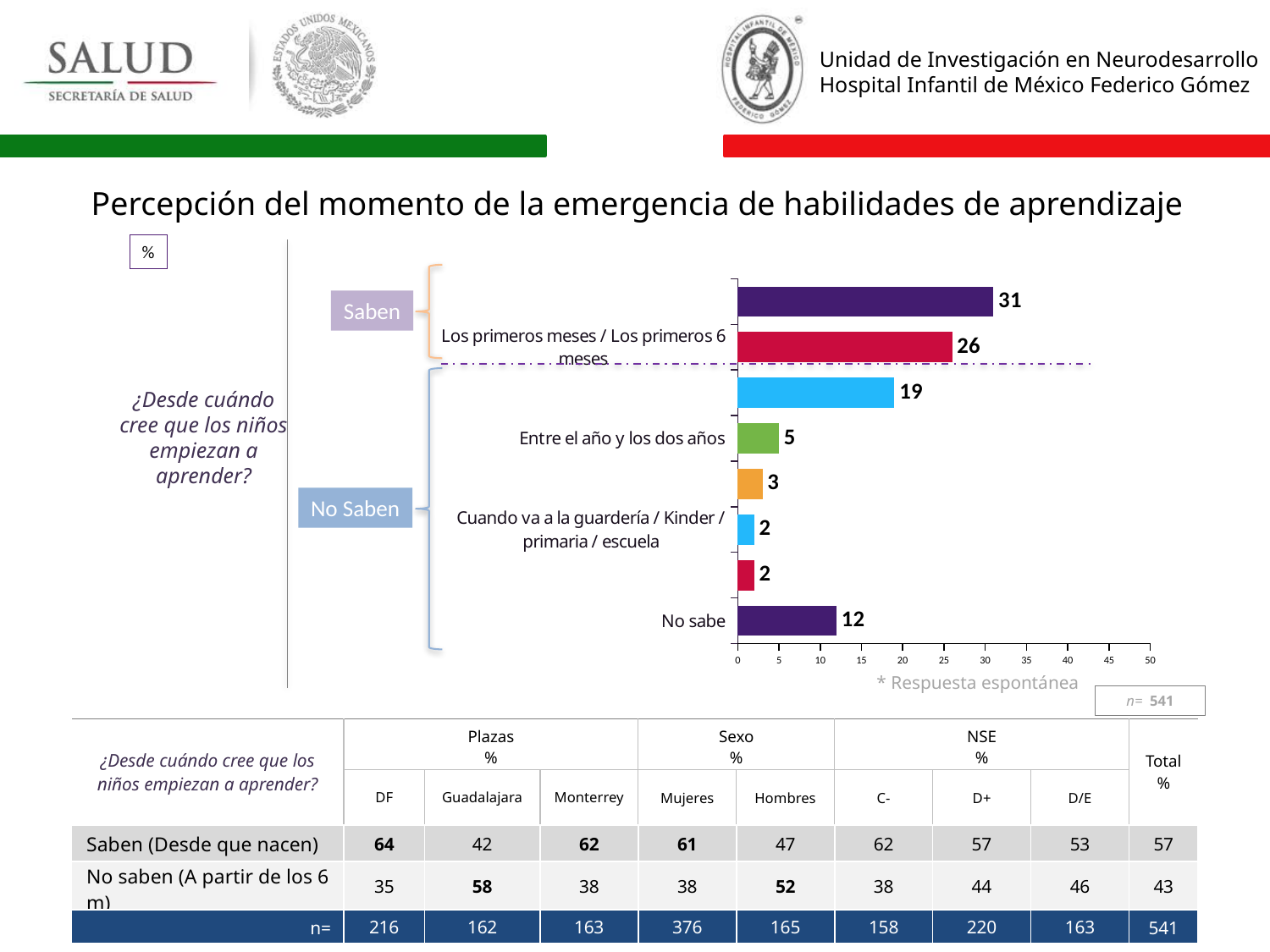
What note appears directly below the chart's axis? * Respuesta espontánea What is the value of the bar labelled 'Entre el año y los dos años'? 5 Is the value of the longest bar in the chart greater or less than 30? greater What is the maximum tick value shown on the chart's horizontal axis? 50 What is the difference between the bar with value 19 and the 'No sabe' bar? 7 What is the value of the bar labelled 'No sabe'? 12 What is the difference between the two longest bars in the chart (31 and 26)? 5 What kind of chart is shown on the slide? bar chart How many bars are plotted in the chart? 8 What is the highest value shown on any bar in the chart? 31 What is the lowest value shown on any bar in the chart? 2 Which bar is larger: 'No sabe' or 'Entre el año y los dos años'? No sabe